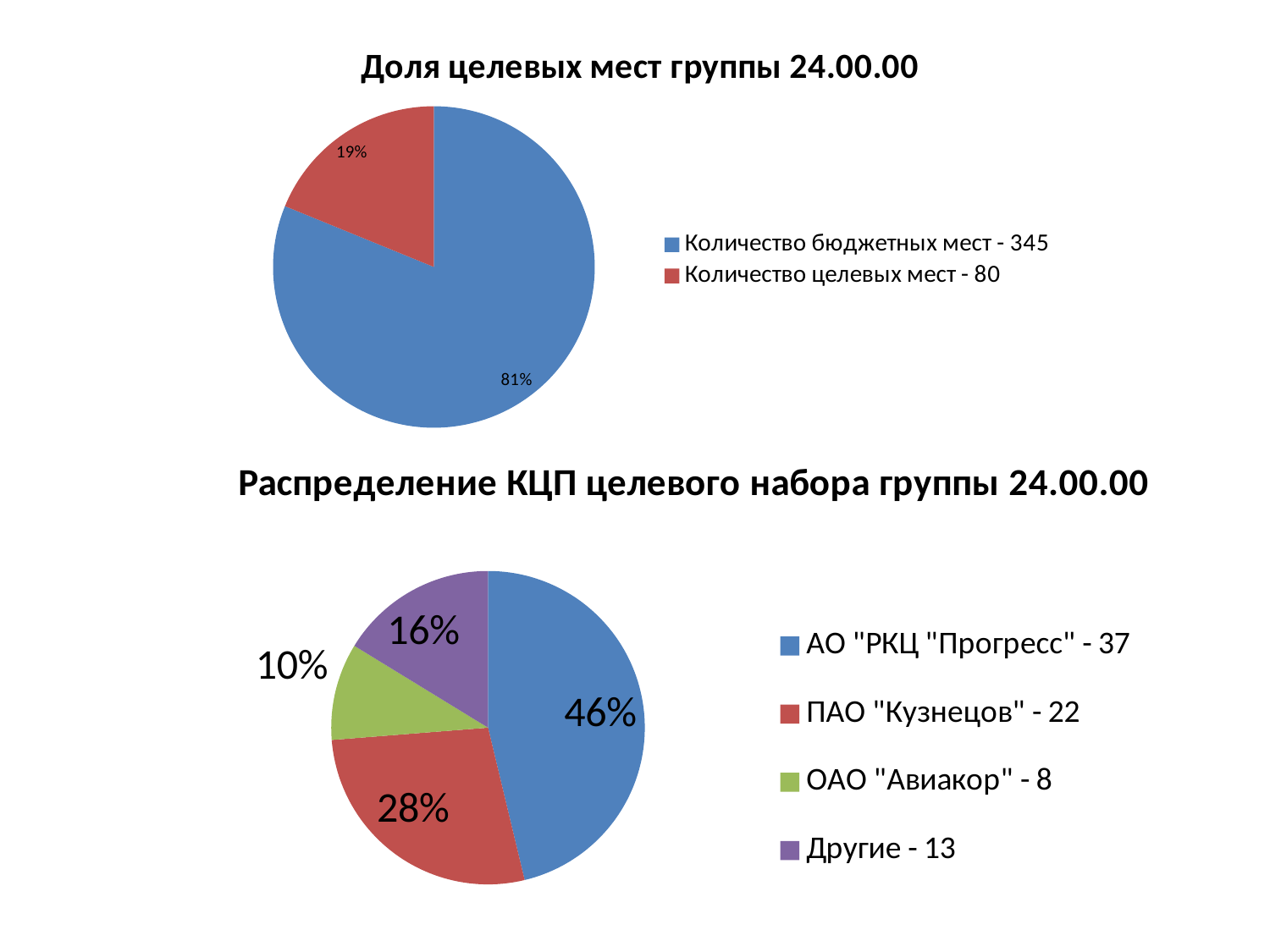
In the bottom chart, which legend entry has the smallest slice? ОАО "Авиакор" - 8 In the bottom chart, what is the difference in percentage points between the "АО "РКЦ "Прогресс" - 37" slice and the "ПАО "Кузнецов" - 22" slice? 18 percentage points In the chart titled "Доля целевых мест группы 24.00.00", what percentage share does the slice "Количество бюджетных мест - 345" have? 81% In the chart titled "Распределение КЦП целевого набора группы 24.00.00", what percentage share does "Другие - 13" have? 16% In the chart titled "Доля целевых мест группы 24.00.00", what percentage share does the slice "Количество целевых мест - 80" have? 19% What type of chart is the top chart on the slide? Pie chart How many entries does the legend of the bottom chart list? 4 In the bottom chart, what colour is the slice for "ОАО "Авиакор" - 8"? Green In the top chart, which slice is larger: "Количество бюджетных мест - 345" or "Количество целевых мест - 80"? Количество бюджетных мест - 345 In the top chart, how many slices does the pie have? 2 In the bottom chart, which legend entry has the largest slice? АО "РКЦ "Прогресс" - 37